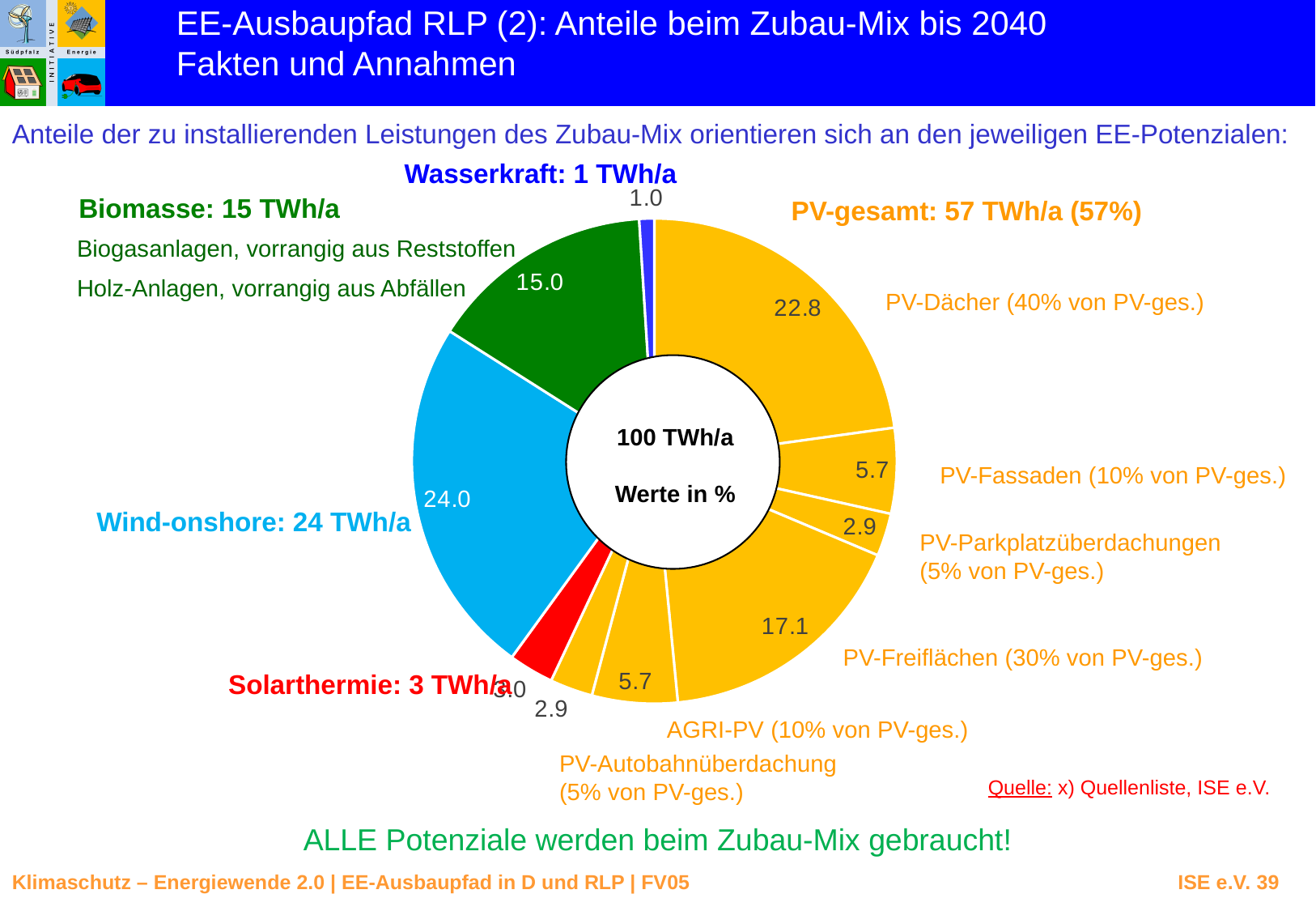
What is the value shown for PV-Dächer in the chart? 22.8 Which is larger, the value for PV-Freiflächen or the value for Biomasse? PV-Freiflächen What is the value shown for Wind-onshore in the chart? 24.0 Which slice of the chart has the smallest value? Wasserkraft What text is shown in the centre of the doughnut chart? 100 TWh/a, Werte in % How many slices does the chart have? 10 What kind of chart is shown on the slide? Pie (doughnut) chart Which slice of the chart has the largest value? Wind-onshore What is the difference between the values for Wind-onshore and PV-Dächer? 1.2 What is the value shown for PV-Freiflächen in the chart? 17.1 What is the value shown for Wasserkraft in the chart? 1.0 What is the value shown for Biomasse in the chart? 15.0